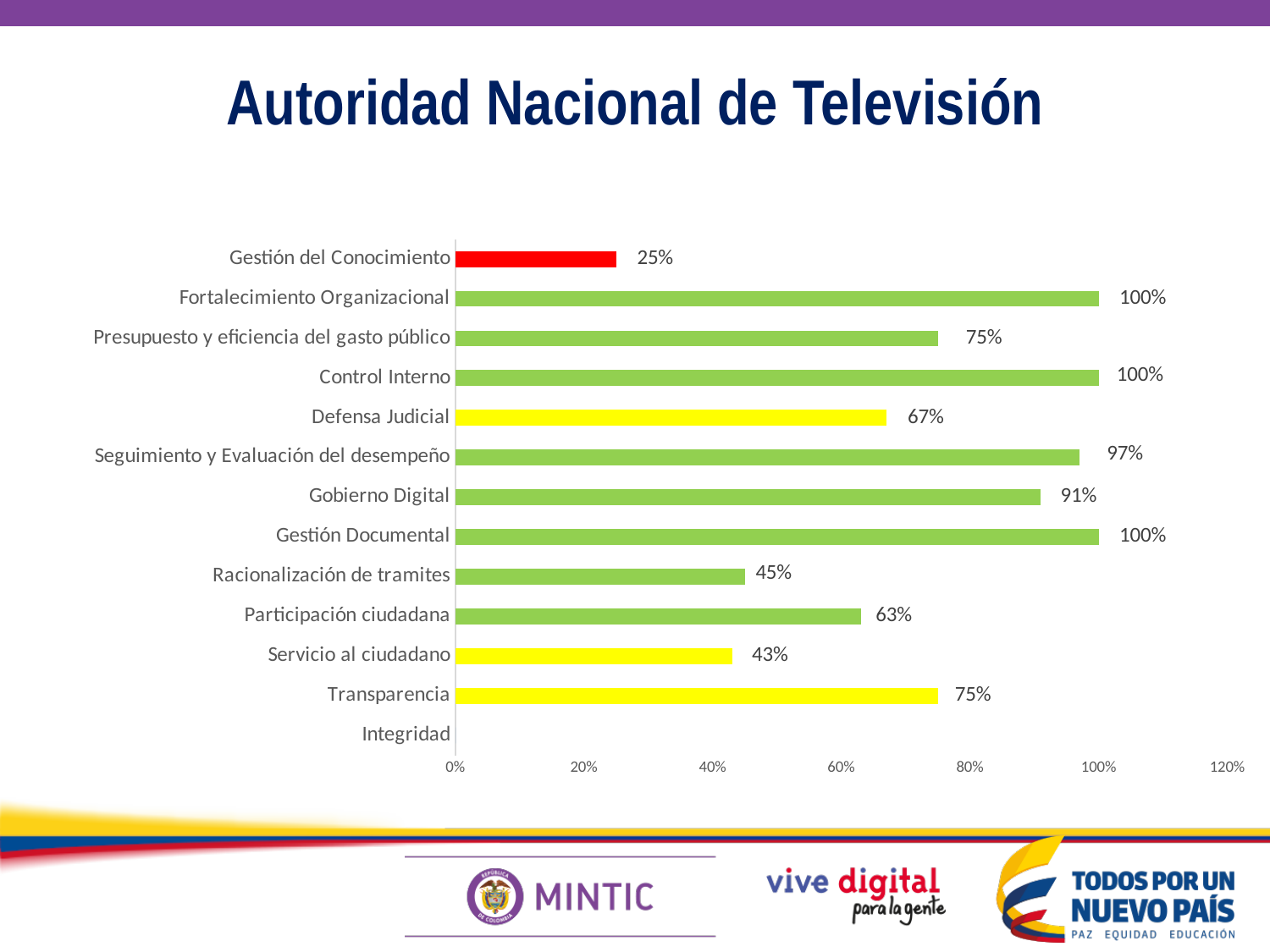
Which is larger, the value for Participación ciudadana or the value for Defensa Judicial? Defensa Judicial What is the value for Racionalización de tramites? 45% What is the difference between the values for Transparencia and Servicio al ciudadano? 32% What is the difference between the values for Gobierno Digital and Participación ciudadana? 28% What kind of chart is shown on the slide? bar chart How many categories are listed on the vertical axis? 13 Which category's bar is coloured red? Gestión del Conocimiento What is the value for Gobierno Digital? 91% Is the value for Servicio al ciudadano greater or less than 60%? less What is the value for Seguimiento y Evaluación del desempeño? 97% What is the value for Defensa Judicial? 67% Among the bars shown, which category has the lowest value? Gestión del Conocimiento